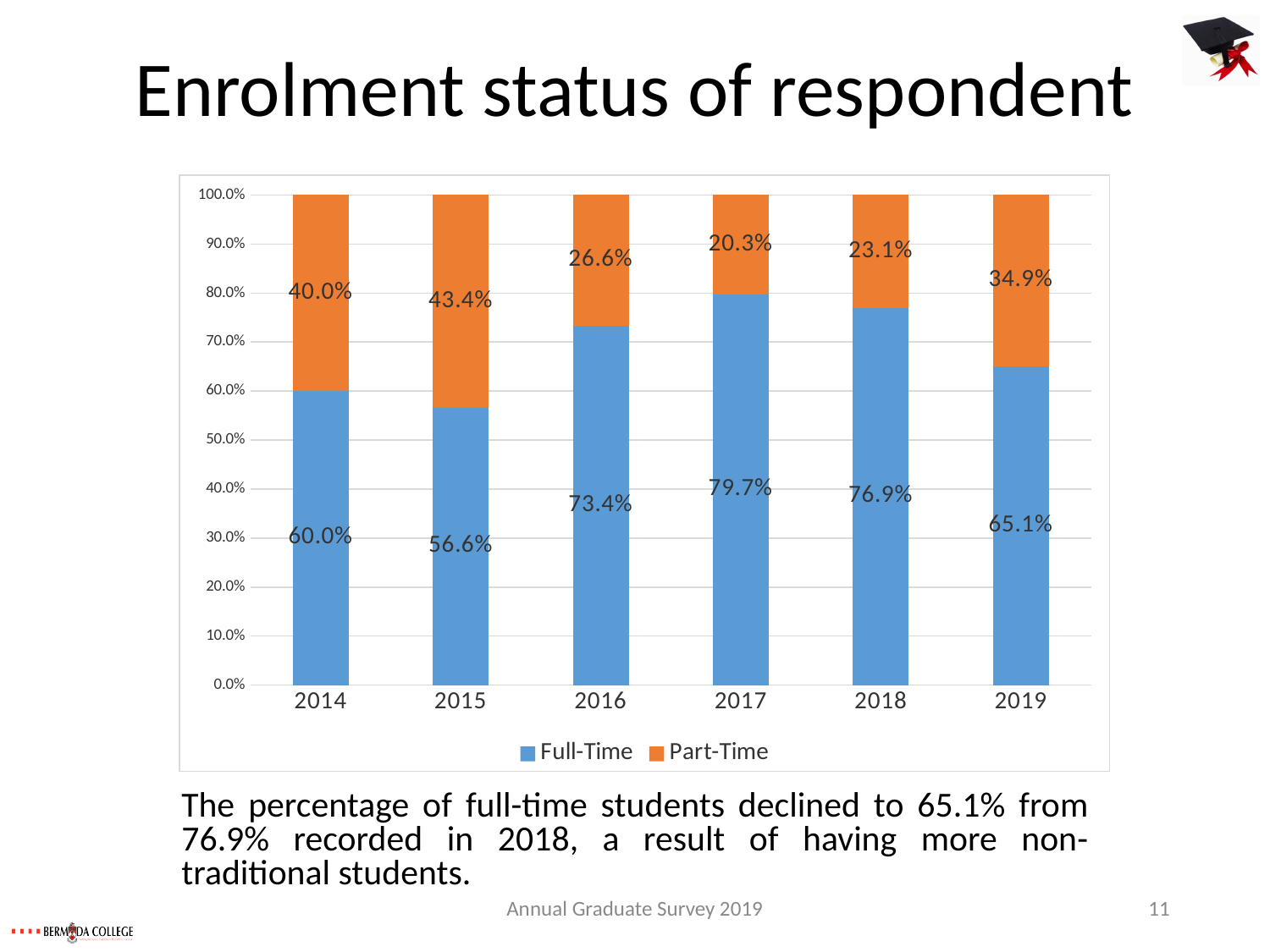
Is the Full-Time value for 2015 greater or less than 60.0%? less Which year has the lowest Part-Time percentage? 2017 What is the Full-Time percentage for 2016? 73.4% How many years are shown on the x axis? 6 Which is larger, the Part-Time percentage in 2014 or in 2016? 2014 What kind of chart is shown on the slide? Stacked bar chart What is the Part-Time percentage for 2019? 34.9% How many series does the legend list? 2 What is the difference between the Full-Time percentage in 2018 and in 2019? 11.8% What is the Part-Time percentage for 2015? 43.4% Which year has the highest Full-Time percentage? 2017 Which year has the lowest Full-Time percentage? 2015